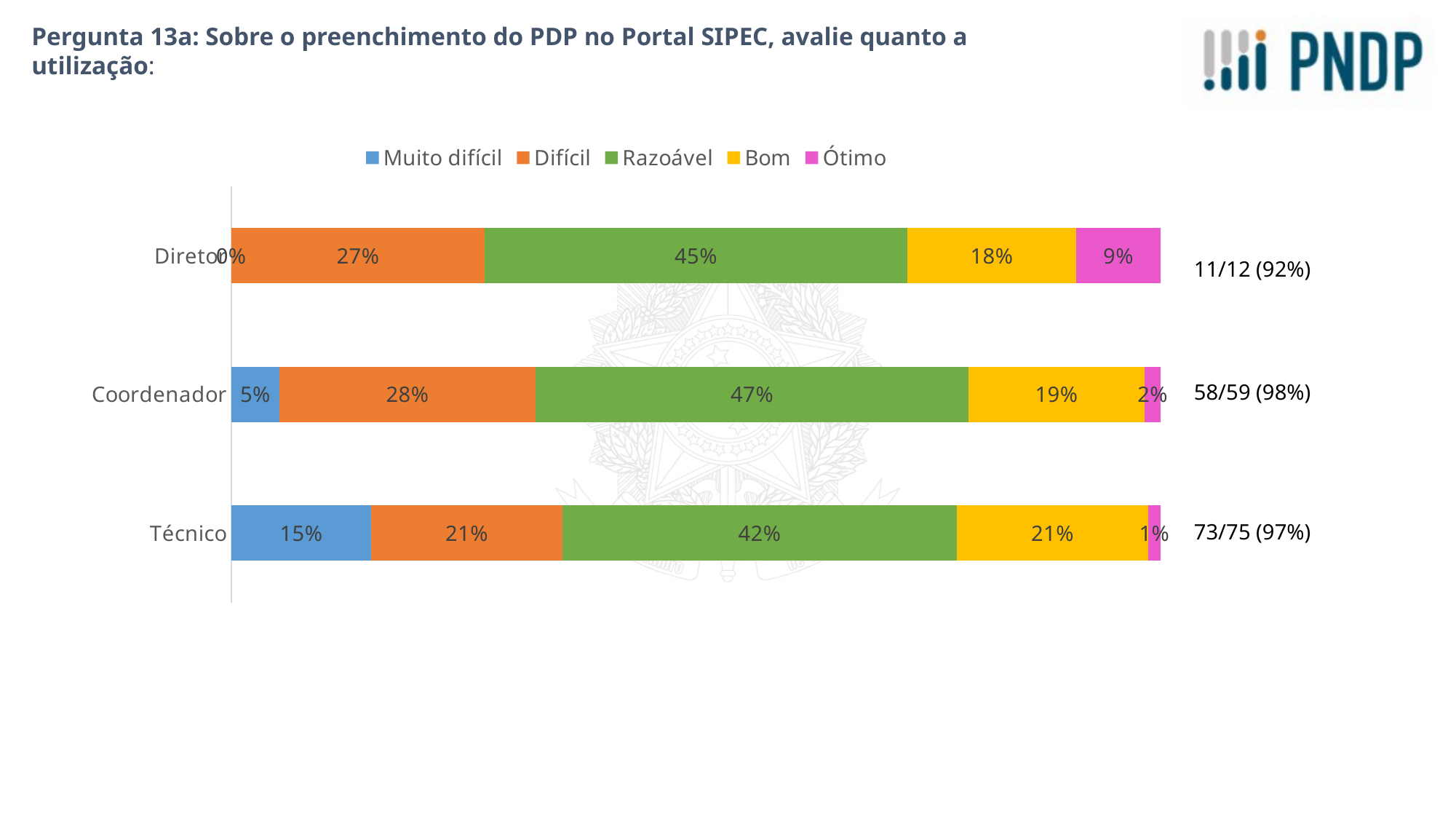
What is the Razoável value for Coordenador? 47% How many categories are plotted on the chart? 3 What kind of chart is shown on the slide? stacked bar chart What is the Muito difícil value for Técnico? 15% What response count is shown next to the Coordenador bar? 58/59 (98%) Which category has the highest Muito difícil value? Técnico What is the difference between the Difícil values for Coordenador and Técnico? 7% Which category has the lowest Ótimo value? Técnico How many series does the legend list? 5 Which is larger, the Razoável value for Diretor or for Técnico? Diretor What is the Bom value for Coordenador? 19% What is the Ótimo value for Diretor? 9%